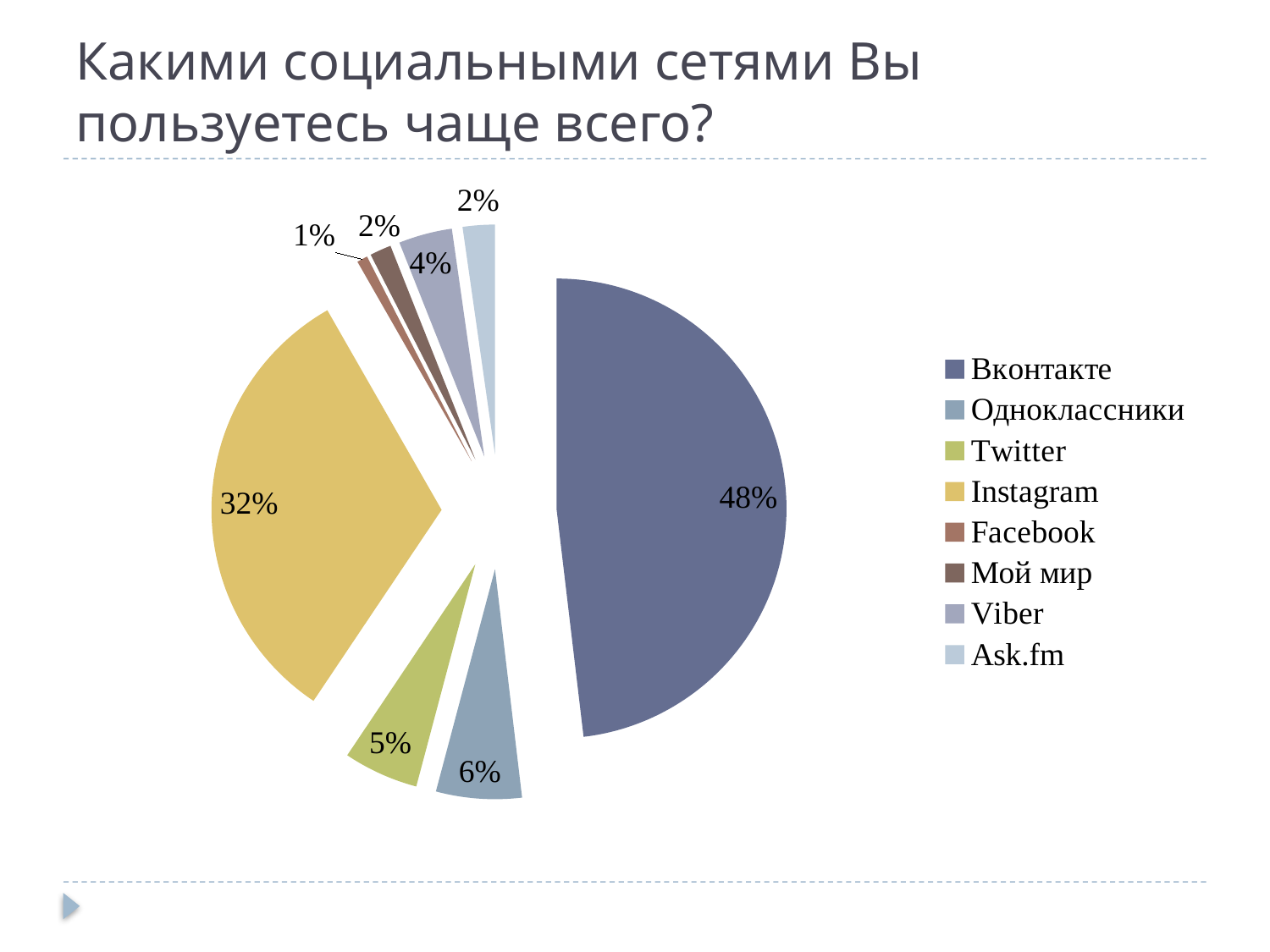
What kind of chart is shown on the slide? Pie chart Which social network has the largest slice of the pie? Вконтакте What is the value for Twitter? 5% Which social network has the smallest slice of the pie? Facebook What share of the pie does Вконтакте have? 48% What is the difference between the shares of Вконтакте and Instagram? 16% What is the value for Viber? 4% What share of the pie does Instagram have? 32% Which is larger, the share for Одноклассники or the share for Twitter? Одноклассники What is the title of the slide containing the chart? Какими социальными сетями Вы пользуетесь чаще всего? How many social networks are listed in the legend? 8 What is the value for Одноклассники? 6%